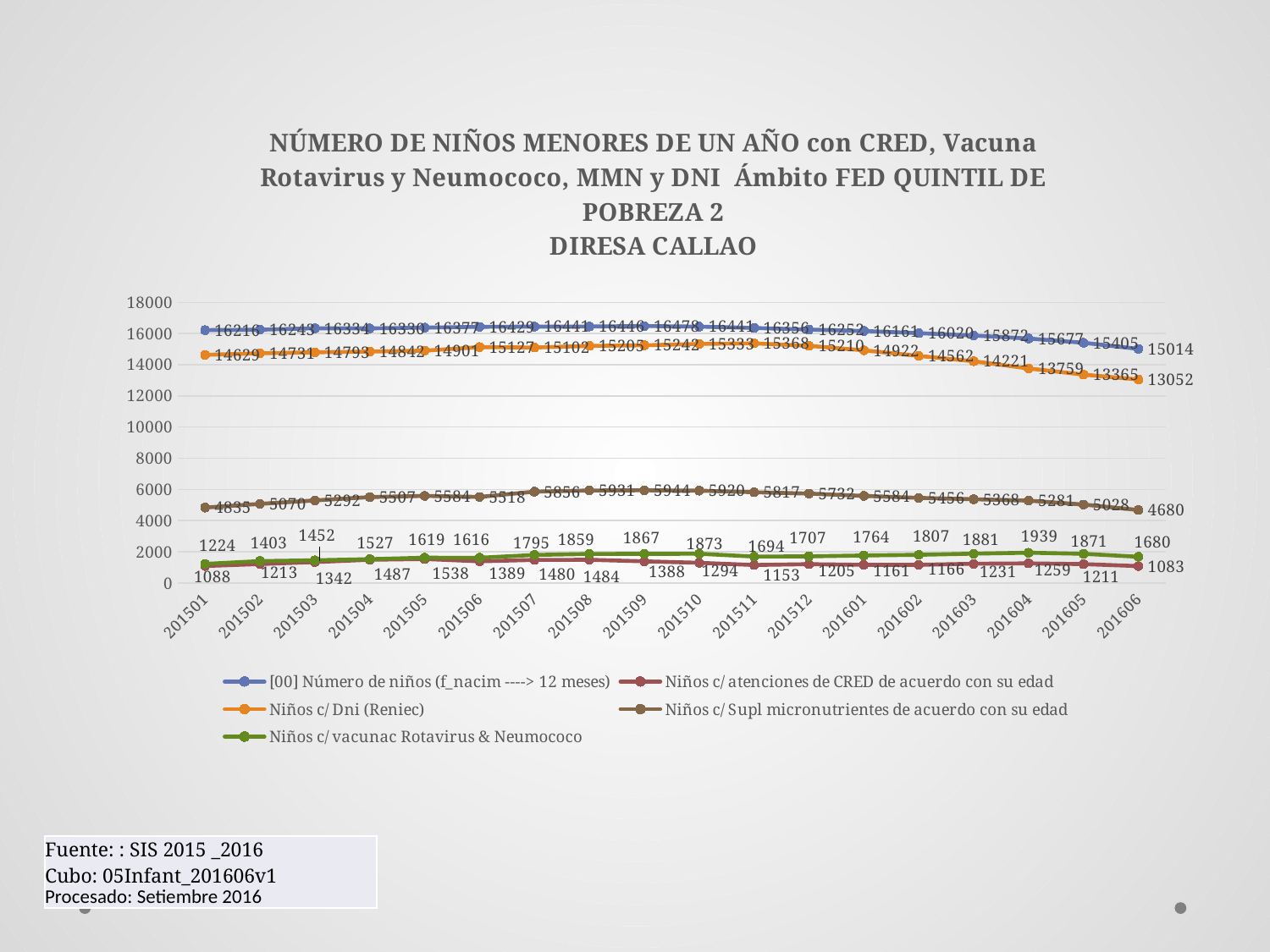
How many months (x-axis points) are plotted on the chart? 18 What is the value of 'Niños c/ Dni (Reniec)' for 201606? 13052 What kind of chart is shown on the slide? line chart In which month does 'Niños c/ vacunac Rotavirus & Neumococo' reach its highest value? 201604 What is the value of '[00] Número de niños (f_nacim ----> 12 meses)' for 201606? 15014 In which month does 'Niños c/ Supl micronutrientes de acuerdo con su edad' reach its lowest value? 201606 In 201606, which is larger: 'Niños c/ vacunac Rotavirus & Neumococo' or 'Niños c/ atenciones de CRED de acuerdo con su edad'? Niños c/ vacunac Rotavirus & Neumococo What is the value of 'Niños c/ Supl micronutrientes de acuerdo con su edad' for 201501? 4835 How many series does the legend list? 5 What is the difference between '[00] Número de niños (f_nacim ----> 12 meses)' and 'Niños c/ Dni (Reniec)' in 201606? 1962 Does 'Niños c/ Dni (Reniec)' rise or fall from 201511 to 201606? fall Is the value for 'Niños c/ Dni (Reniec)' in 201606 greater or less than 14000? less